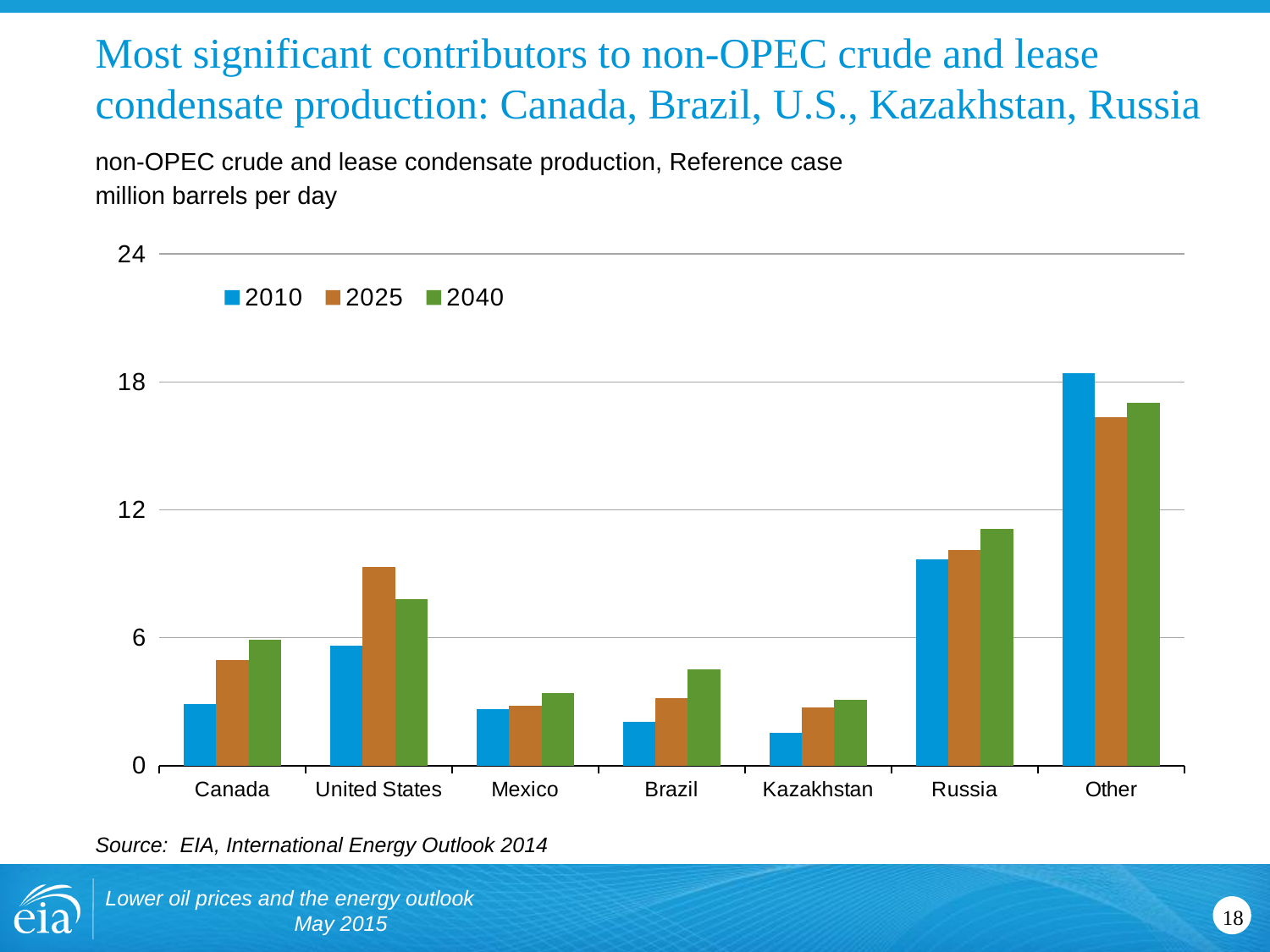
Which is larger in 2025, the value for the United States or the value for Canada? United States What unit is the production measured in, according to the chart subtitle? million barrels per day Among the named countries (excluding Other), which has the highest 2040 value? Russia Which category has the lowest 2010 value? Kazakhstan What kind of chart is shown on the slide? bar chart Is the 2010 value for Canada greater or less than 6? less Which category has the highest 2010 value? Other Is the 2025 value for the United States greater or less than 6? greater How many series does the legend list? 3 Do the values for Canada rise or fall from 2010 to 2040? rise Is the 2025 value for Other greater or less than 18? less How many categories are shown on the x axis? 7